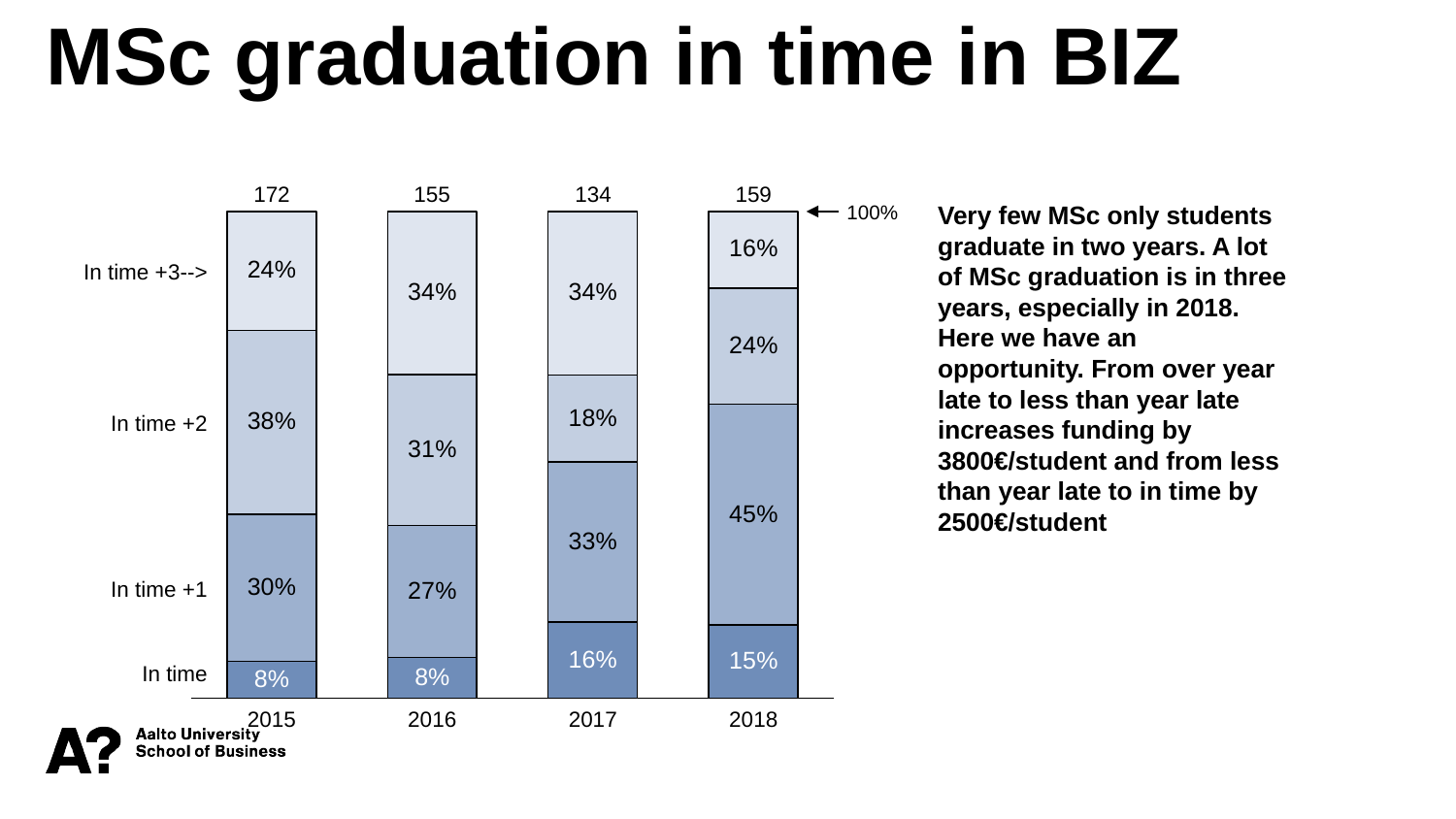
What percentage of MSc students graduated 'In time' in 2017? 16% What kind of chart is shown on the slide? Stacked bar chart What label does the arrow at the top right of the bars point to? 100% What number is printed above the 2018 bar? 159 What is the 'In time +2' share for 2015? 38% Which year has the lowest number printed above its bar? 2017 Does the 'In time +1' share rise or fall from 2016 to 2018? Rises How many years are shown on the x axis? 4 How many percentage points higher is the 'In time +3-->' share in 2016 than in 2018? 18 percentage points Which year has the larger 'In time +2' share, 2016 or 2017? 2016 Which year has the highest 'In time +1' percentage? 2018 How many segments (graduation-time categories) make up each stacked bar? 4